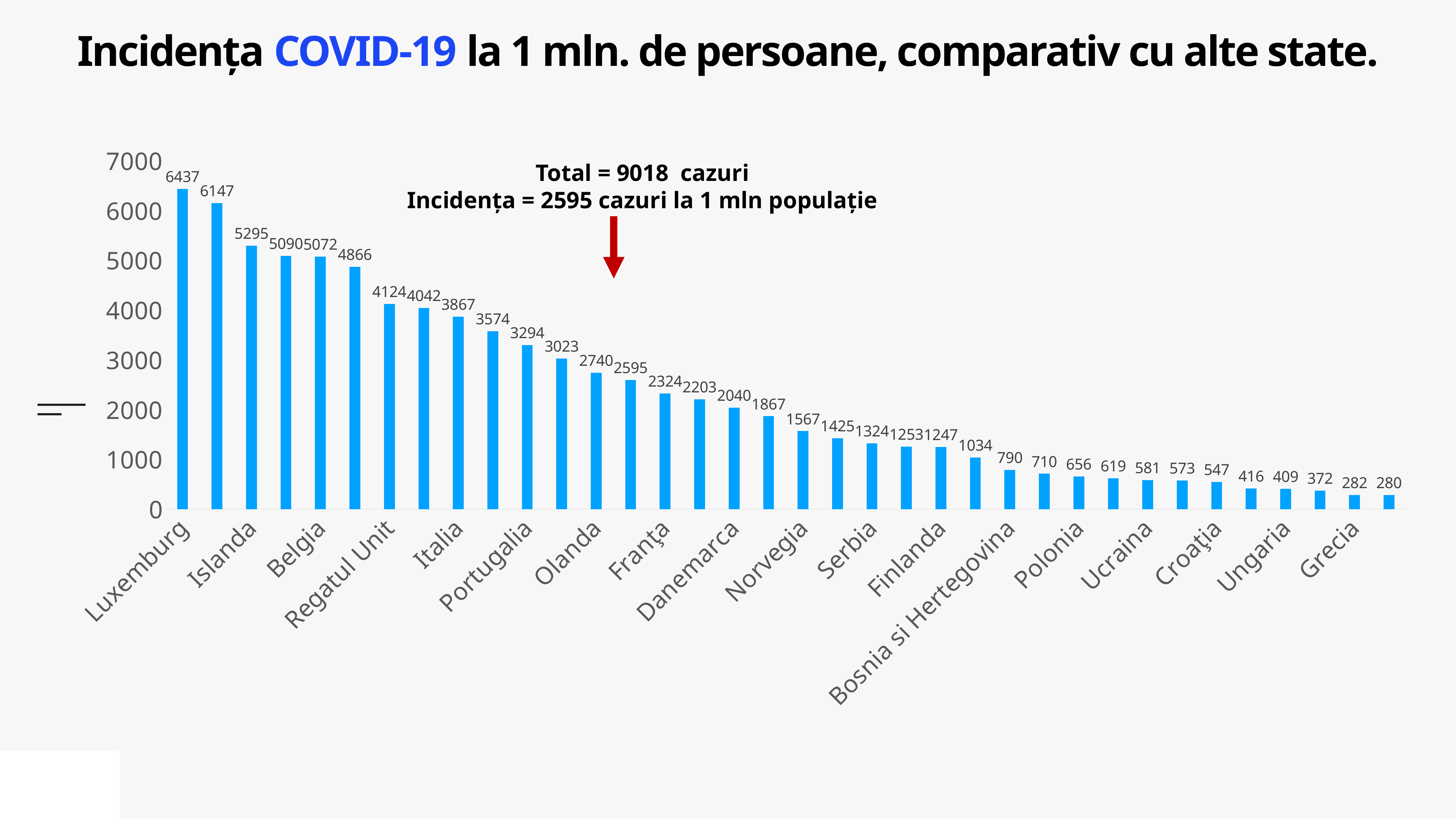
What is the difference between the values for Luxemburg and Islanda? 1142 Do the values rise or fall from left to right along the x axis? fall What is the incidence value shown for Polonia? 656 According to the annotation on the chart, what is the total number of cases? 9018 What type of chart is shown on the slide? bar chart Which has a higher incidence, Luxemburg or Grecia? Luxemburg What is the incidence value shown for Italia? 3867 How many bars are plotted in the chart? 36 What is the incidence value shown for Luxemburg? 6437 What is the incidence value shown for Islanda? 5295 Which country has the highest COVID-19 incidence per 1 million people in the chart? Luxemburg Is the value for Luxemburg greater or less than 6000? greater